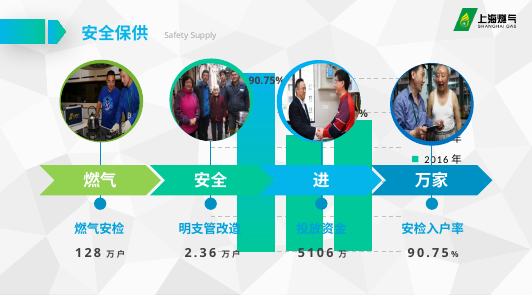
What is the legend entry shown on the chart? 2016年 What kind of chart is partially visible on the slide? bar chart What percentage value is printed as a data label at the top of the chart? 90.75%